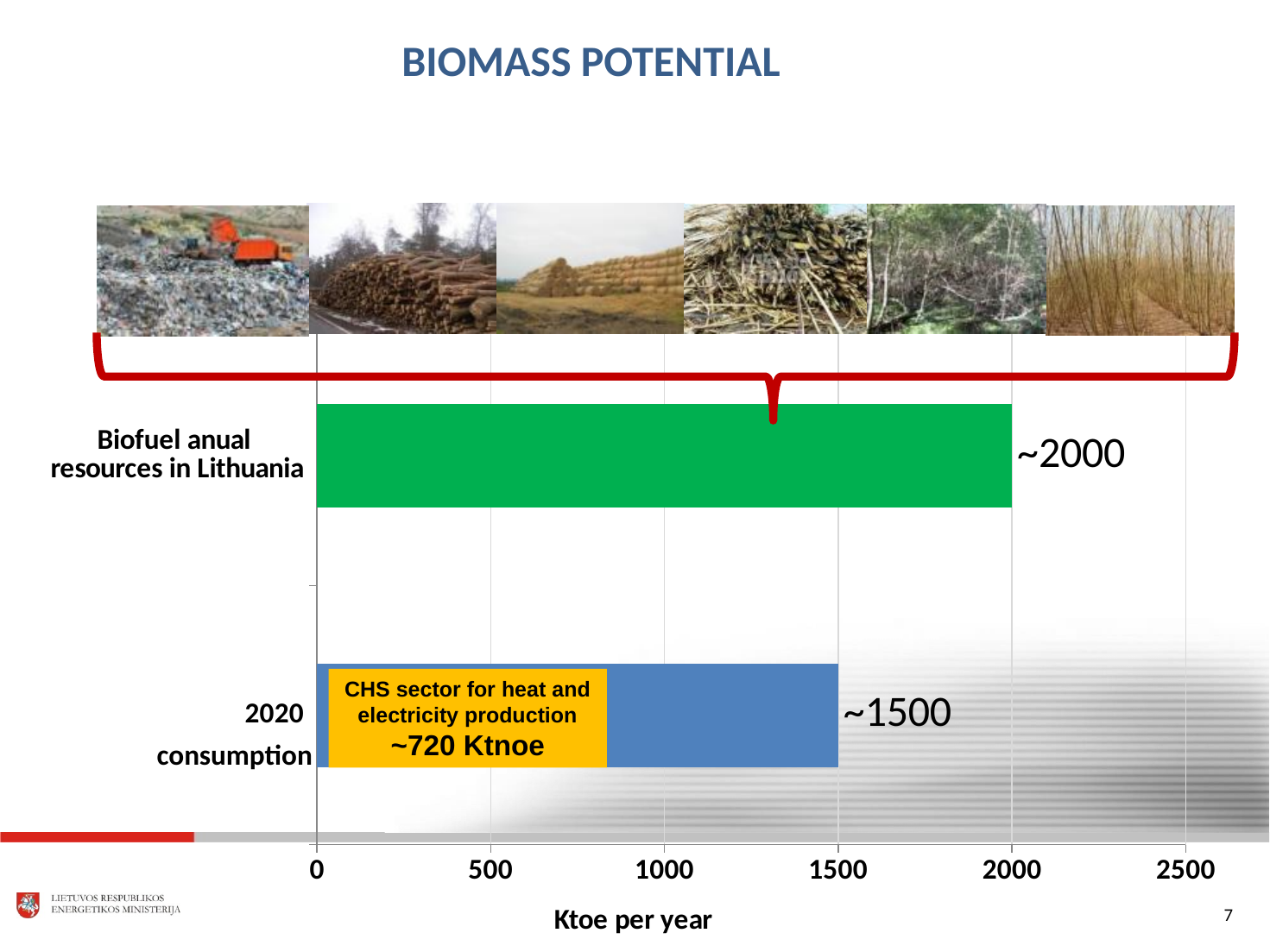
Which is larger: Biofuel anual resources in Lithuania or 2020 consumption? Biofuel anual resources in Lithuania Is the value for 2020 consumption greater or less than 1000? greater What kind of chart is shown on the slide? bar chart How many categories (bars) does the chart show? 2 What value label is printed next to the bar for Biofuel anual resources in Lithuania? ~2000 Which category has the lowest value? 2020 consumption What value is printed in the yellow box for the CHS sector for heat and electricity production? ~720 Ktnoe Is the value for 2020 consumption greater or less than 2000? less What value label is printed next to the bar for 2020 consumption? ~1500 What is the title of the horizontal axis? Ktoe per year Which category has the highest value? Biofuel anual resources in Lithuania Is the value for Biofuel anual resources in Lithuania greater or less than 2500? less